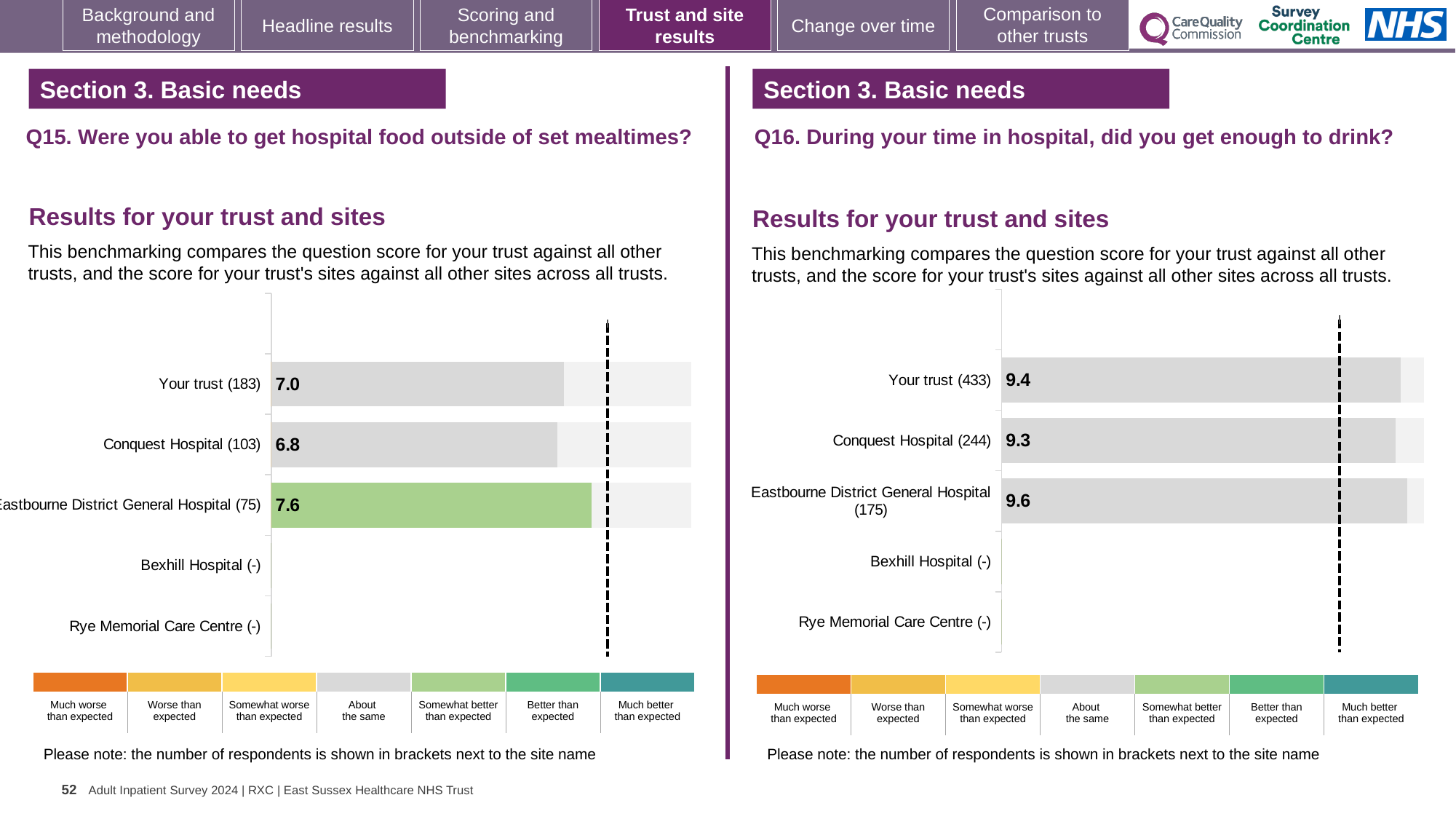
On the Q15 chart (left), what is the score for Conquest Hospital? 6.8 On the Q15 chart (left), which bar is coloured green rather than grey? Eastbourne District General Hospital On the Q16 chart (right), what is the score for Your trust? 9.4 On the Q15 chart (left), what is the score for Your trust? 7.0 On the Q15 chart (left), what is the difference between the scores for Eastbourne District General Hospital and Conquest Hospital? 0.8 On the Q16 chart (right), what is the score for Eastbourne District General Hospital? 9.6 On the Q15 chart (left), which site or trust has the lowest score among those with a value shown? Conquest Hospital On the Q15 chart (left), which site or trust has the highest score? Eastbourne District General Hospital On the Q16 chart (right), how many sites or trusts are listed on the vertical axis? 5 On the Q16 chart (right), which is larger, the score for Conquest Hospital or the score for Eastbourne District General Hospital? Eastbourne District General Hospital On the Q16 chart (right), what is the difference between the scores for Your trust and Conquest Hospital? 0.1 What kind of chart is used on the Q15 chart (left)? Bar chart